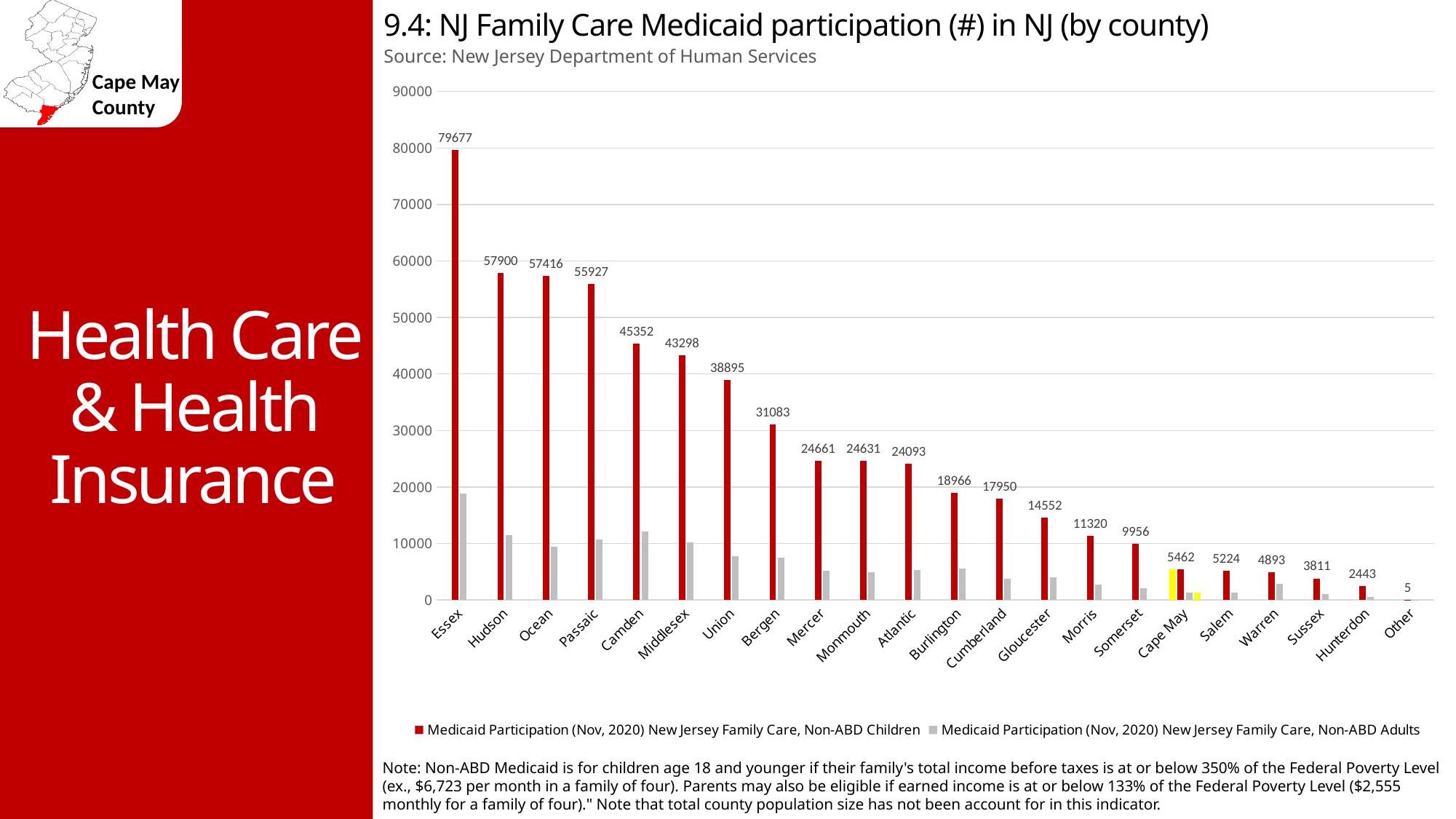
Which county has the highest Non-ABD Children Medicaid participation? Essex Which has a larger Non-ABD Children Medicaid participation, Camden or Union? Camden Is the Non-ABD Adults Medicaid participation value for Essex greater or less than 10000? greater Is the Non-ABD Adults Medicaid participation value for Cape May greater or less than 10000? less What is the Non-ABD Children Medicaid participation value for Essex? 79677 What type of chart is shown on the slide? Bar chart What is the Non-ABD Children Medicaid participation value for Cape May? 5462 How many categories are shown on the x axis of the chart? 22 How many series does the legend list? 2 What is the Non-ABD Children Medicaid participation value for Somerset? 9956 Which county has the lowest Non-ABD Children Medicaid participation (excluding the 'Other' category)? Hunterdon What is the difference in Non-ABD Children Medicaid participation between Cape May and Salem? 238